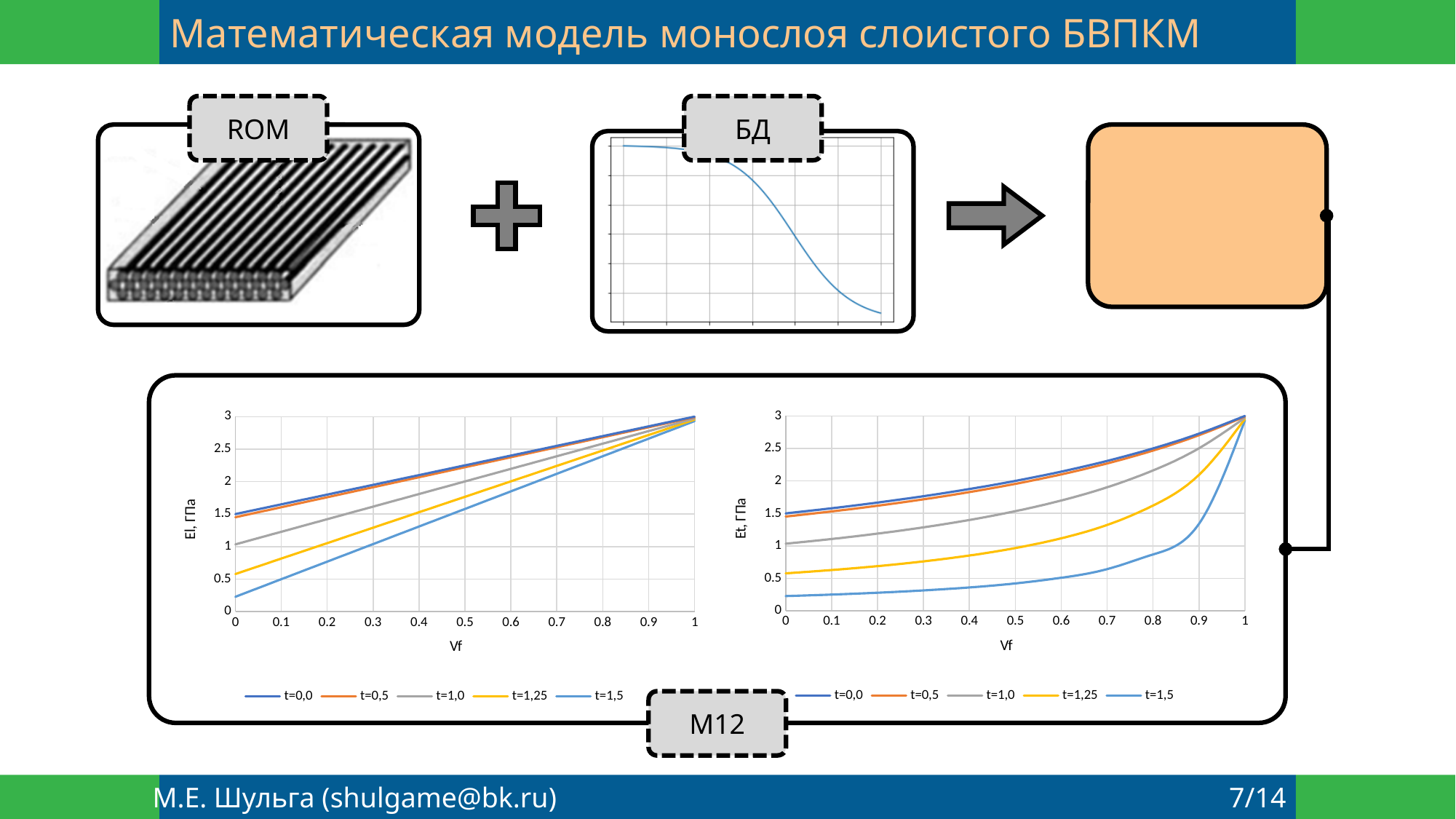
In the left chart (El, ГПа vs Vf), does the t=1,5 series rise or fall as Vf increases? rise How many series does the legend of the right chart (Et, ГПа vs Vf) list? 5 In the left chart (El, ГПа vs Vf), is the value of the t=1,5 series at Vf=0.5 greater or less than 2? less In the left chart (El, ГПа vs Vf), which series has the higher value at Vf=0.5: t=1,0 or t=1,25? t=1,0 In the right chart (Et, ГПа vs Vf), is the value of the t=1,25 series at Vf=0.8 greater or less than 2? less What are the legend entries of the left chart (El, ГПа vs Vf)? t=0,0, t=0,5, t=1,0, t=1,25, t=1,5 In the right chart (Et, ГПа vs Vf), does the t=1,5 series rise or fall as Vf increases? rise What kind of chart is the left chart (El, ГПа vs Vf) at the bottom of the slide? line chart In the right chart (Et, ГПа vs Vf), which series has the higher value at Vf=0.7: t=0,0 or t=1,5? t=0,0 In the left chart (El, ГПа vs Vf), which series has the lowest value at Vf=0? t=1,5 What is the y-axis label of the right chart at the bottom of the slide? Et, ГПа In the right chart (Et, ГПа vs Vf), is the value of the t=1,5 series at Vf=0.5 greater or less than 0.5? less